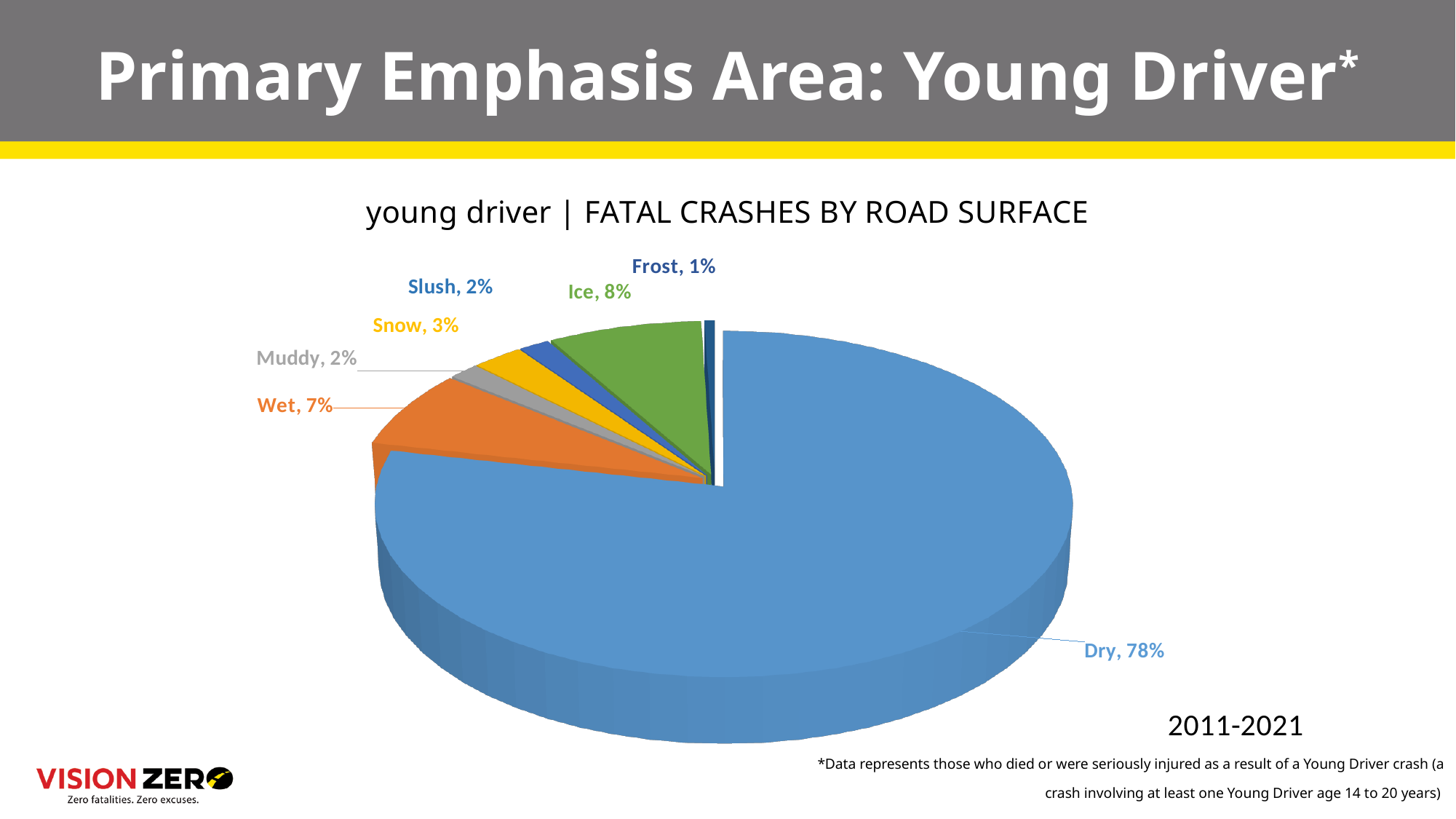
What is the title of the chart? young driver | FATAL CRASHES BY ROAD SURFACE What percentage is shown for Ice? 8% What share of young driver fatal crashes occurred on a dry road surface? 78% How many road surface categories are shown in the pie chart? 7 What type of chart is used on this slide? Pie chart What is the difference in percentage points between Dry and Ice? 70 Which road surface category has the smallest share of fatal crashes? Frost What percentage is shown for Snow? 3% What is the difference in percentage points between Ice and Wet? 1 What percentage of fatal crashes is shown for the Wet road surface? 7% Which has a larger share, Wet or Snow? Wet Which road surface category has the largest share of fatal crashes? Dry